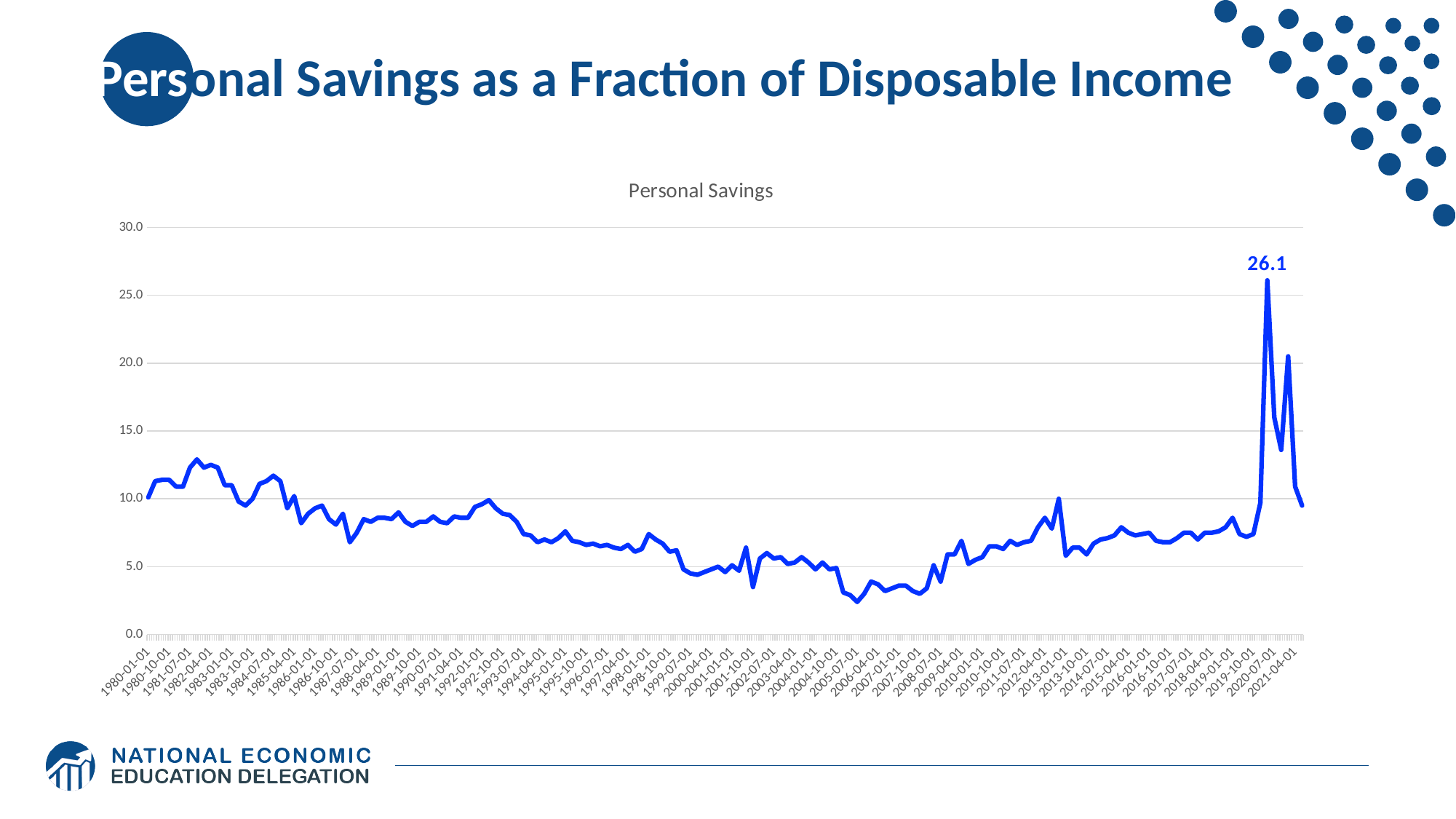
What is the title of the chart? Personal Savings What is the highest value labeled on the Personal Savings line? 26.1 Is the value for 1987-07-01 greater or less than 5.0? greater Which is larger, the value for 1982-04-01 or the value for 2005-07-01? 1982-04-01 Is the value for 2005-07-01 greater or less than 5.0? less Do the values generally rise or fall between 2006 and 2019? rise Is the value for 2021-04-01 greater or less than 15.0? less Do the values generally rise or fall between 1982 and 2005? fall What is the highest tick value shown on the y axis? 30.0 What kind of chart is shown on the slide? line chart